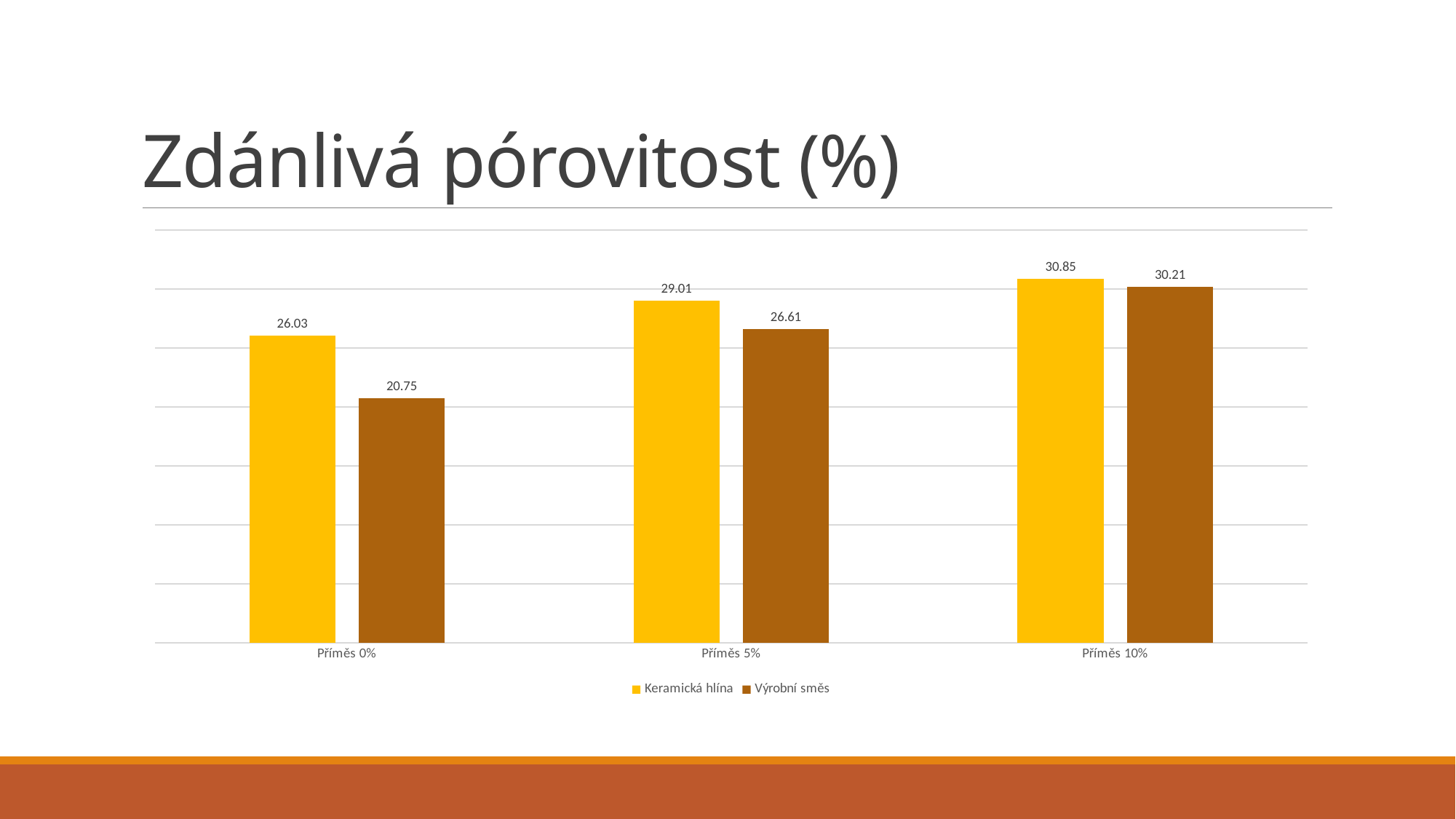
What is the difference between Keramická hlína and Výrobní směs at Příměs 0%? 5.28 Which category has the lowest value for Výrobní směs? Příměs 0% Which is larger at Příměs 5%: Keramická hlína or Výrobní směs? Keramická hlína What is the value for Keramická hlína at Příměs 0%? 26.03 What is the value for Výrobní směs at Příměs 5%? 26.61 How many categories are shown on the x axis? 3 What is the value for Výrobní směs at Příměs 10%? 30.21 How many series does the legend list? 2 Do the values for Výrobní směs rise or fall from Příměs 0% to Příměs 10%? Rise What kind of chart is shown on the slide? Bar chart What is the difference between Keramická hlína at Příměs 10% and at Příměs 5%? 1.84 Which category has the highest value for Keramická hlína? Příměs 10%